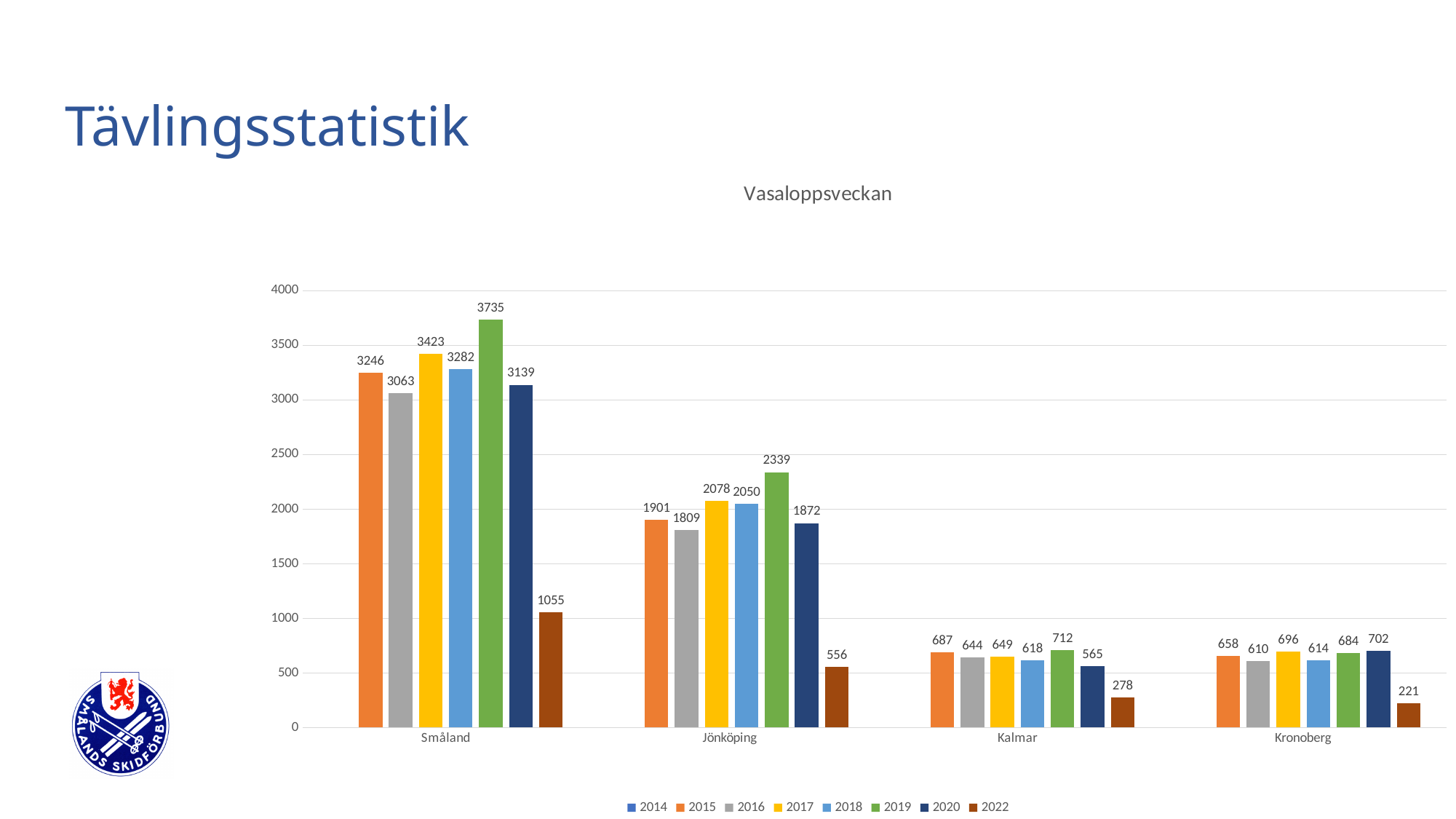
What is the title of the chart? Vasaloppsveckan How many series does the legend list? 8 What is the value for Småland in 2019? 3735 What kind of chart is shown? bar chart What is the value for Jönköping in 2022? 556 Which year has the lowest value for Kronoberg? 2022 Which year has the highest value for Jönköping? 2019 What is the value for Kronoberg in 2020? 702 What is the value for Kalmar in 2015? 687 What is the difference between the 2019 and 2022 values for Småland? 2680 Which is larger, the 2017 value for Kalmar or the 2017 value for Kronoberg? Kronoberg How many categories are shown on the x axis? 4